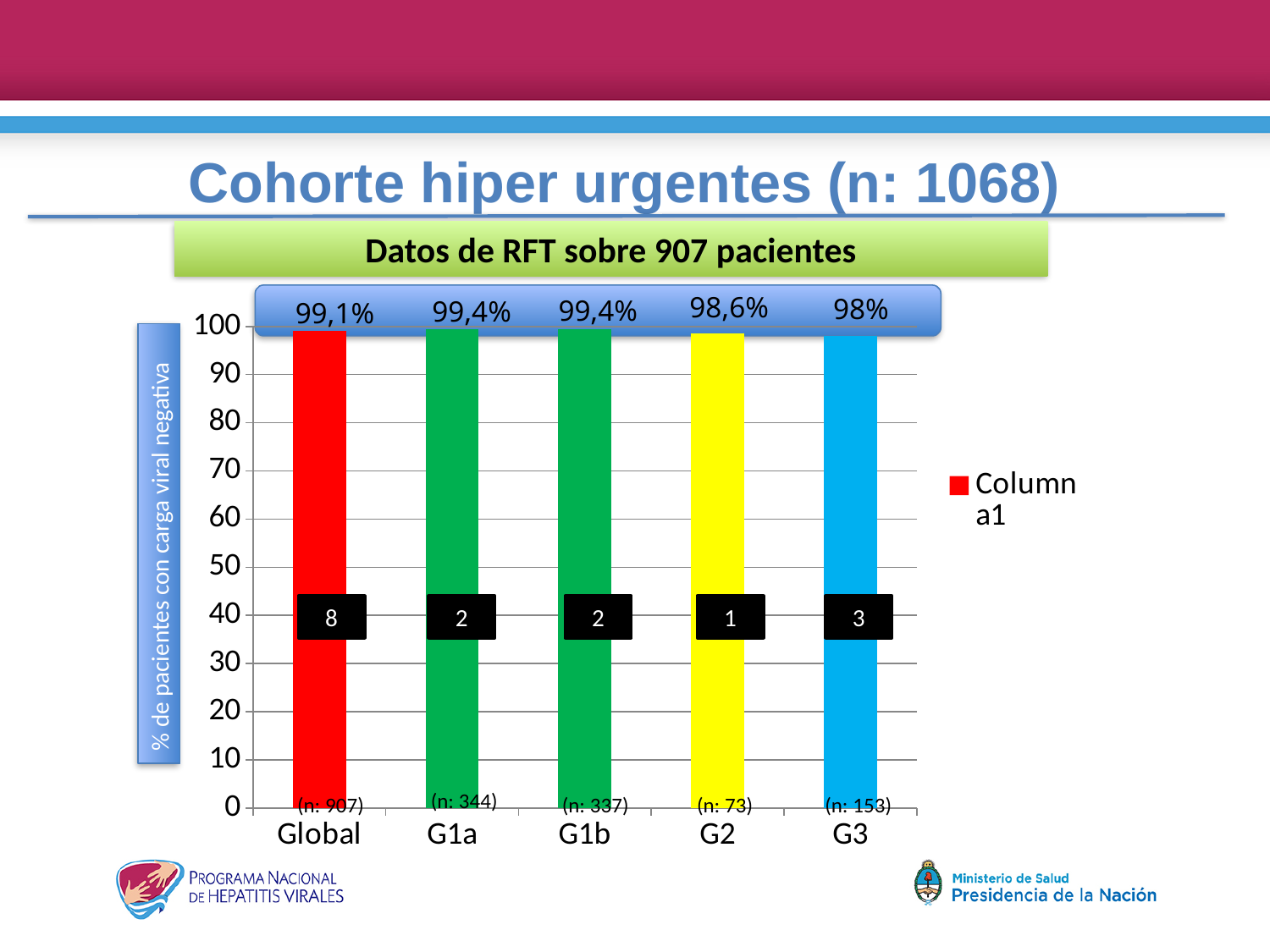
How many categories are plotted on the x axis of the chart? 5 How many series does the chart legend list? 1 What is the difference between the percentage values for G1b and G3? 1,4% What is the label on the y axis of the chart? % de pacientes con carga viral negativa What is the percentage value shown for G1a? 99,4% Which has a higher percentage value, Global or G2? Global Which category has the lowest percentage value? G3 What is the percentage value shown for G2? 98,6% What is the percentage value shown for G3? 98% What is the n value shown for the G1b category? 337 What is the percentage value shown for the Global category? 99,1% What type of chart is shown on the slide? bar chart